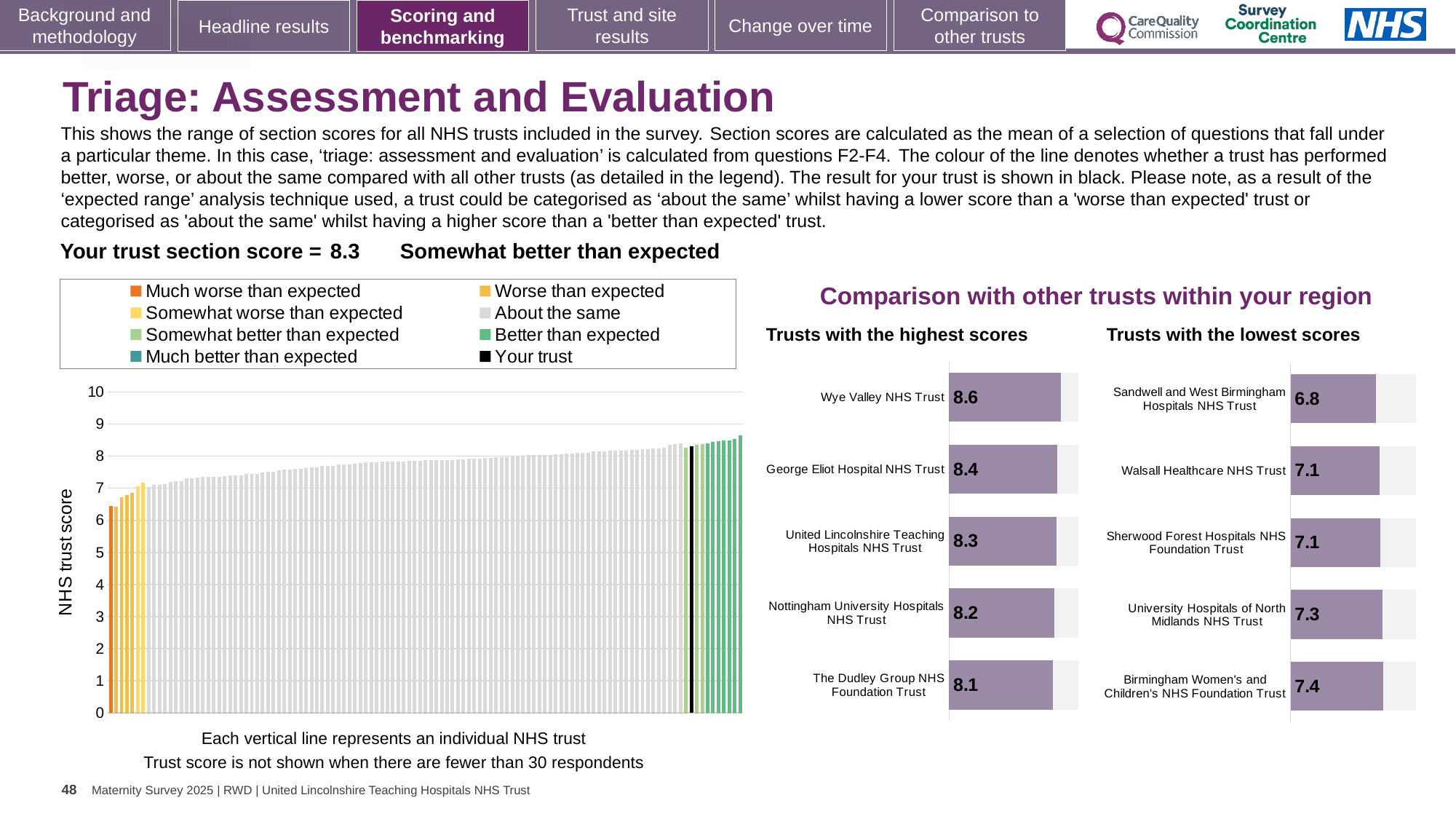
In the 'Trusts with the highest scores' chart, what is the difference between the scores of Wye Valley NHS Trust and The Dudley Group NHS Foundation Trust? 0.5 In the 'Trusts with the highest scores' chart, how many trusts are shown? 5 How many entries does the legend of the main 'NHS trust score' chart list? 8 In the main 'NHS trust score' chart on the left, what kind of chart is it? Bar chart In the 'Trusts with the lowest scores' chart, which trust has the lowest score? Sandwell and West Birmingham Hospitals NHS Trust In the 'Trusts with the lowest scores' chart, which has the larger score: University Hospitals of North Midlands NHS Trust or Walsall Healthcare NHS Trust? University Hospitals of North Midlands NHS Trust In the 'Trusts with the highest scores' chart, what is the score for Wye Valley NHS Trust? 8.6 In the main 'NHS trust score' chart on the left, is the value of the leftmost (lowest) bar greater or less than 7? less In the 'Trusts with the highest scores' chart, which trust has the highest score? Wye Valley NHS Trust In the main 'NHS trust score' chart on the left, do the values rise or fall from left to right? Rise In the 'Trusts with the lowest scores' chart, what is the score for Birmingham Women's and Children's NHS Foundation Trust? 7.4 In the 'Trusts with the lowest scores' chart, what is the score for Sandwell and West Birmingham Hospitals NHS Trust? 6.8